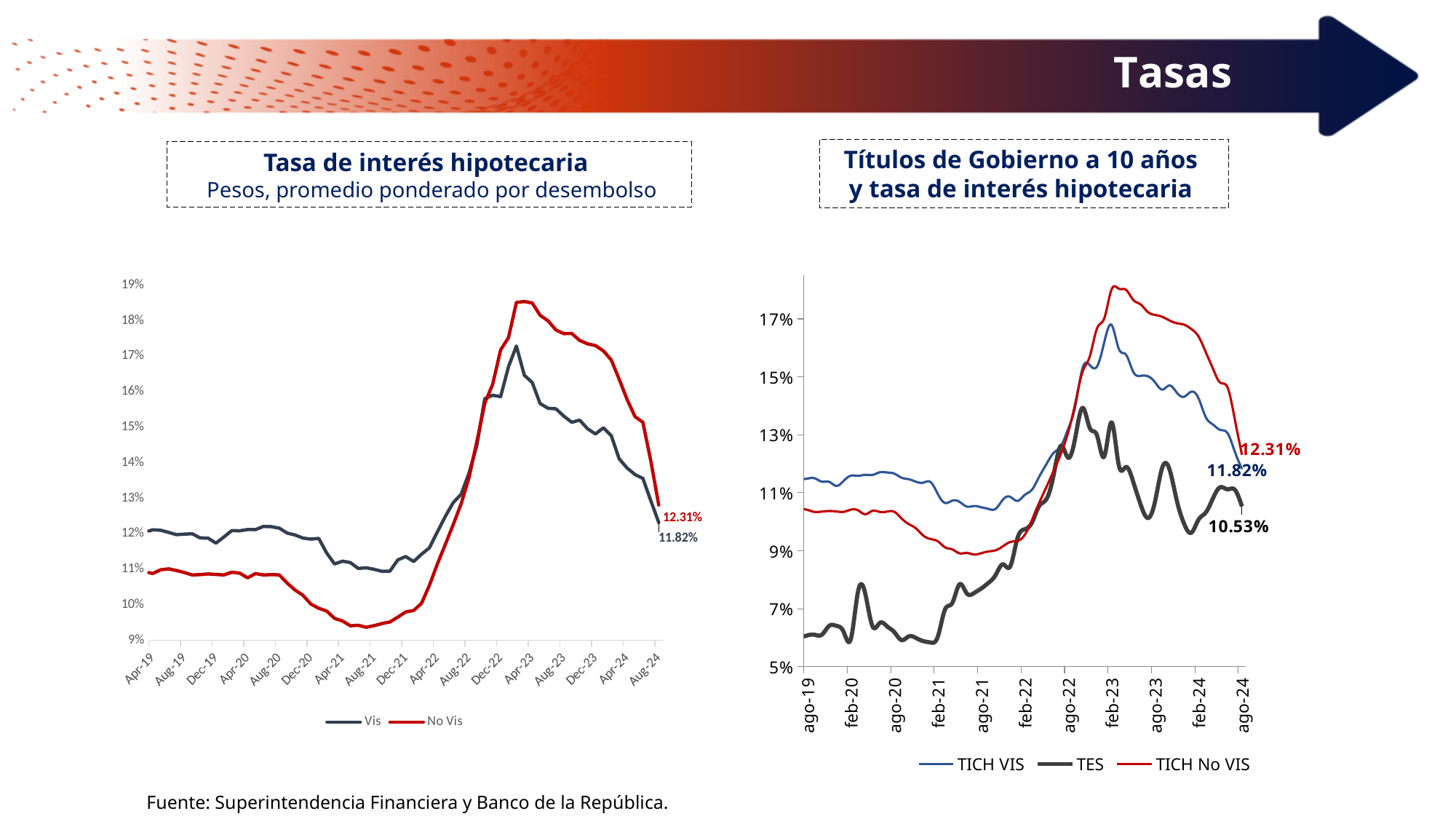
In the 'Títulos de Gobierno a 10 años y tasa de interés hipotecaria' chart, what is the final value shown for TICH No VIS? 12.31% What type of chart is the 'Tasa de interés hipotecaria' chart? Line chart In the 'Tasa de interés hipotecaria' chart, what is the difference between the final No Vis value and the final Vis value? 0.49% In the 'Títulos de Gobierno a 10 años y tasa de interés hipotecaria' chart, which series has the lowest final value? TES In the 'Títulos de Gobierno a 10 años y tasa de interés hipotecaria' chart, is the TES value at ago-19 greater or less than 7%? less How many series does the legend of the 'Tasa de interés hipotecaria' chart list? 2 In the 'Tasa de interés hipotecaria' chart, which series ends higher at Aug-24, Vis or No Vis? No Vis In the 'Títulos de Gobierno a 10 años y tasa de interés hipotecaria' chart, what is the final value shown for the TES series? 10.53% In the 'Tasa de interés hipotecaria' chart, is the No Vis value at Aug-21 greater or less than 10%? less In the 'Tasa de interés hipotecaria' chart, what is the final value shown for the Vis series? 11.82% How many series does the legend of the 'Títulos de Gobierno a 10 años y tasa de interés hipotecaria' chart list? 3 In the 'Tasa de interés hipotecaria' chart, what is the final value shown for the No Vis series? 12.31%